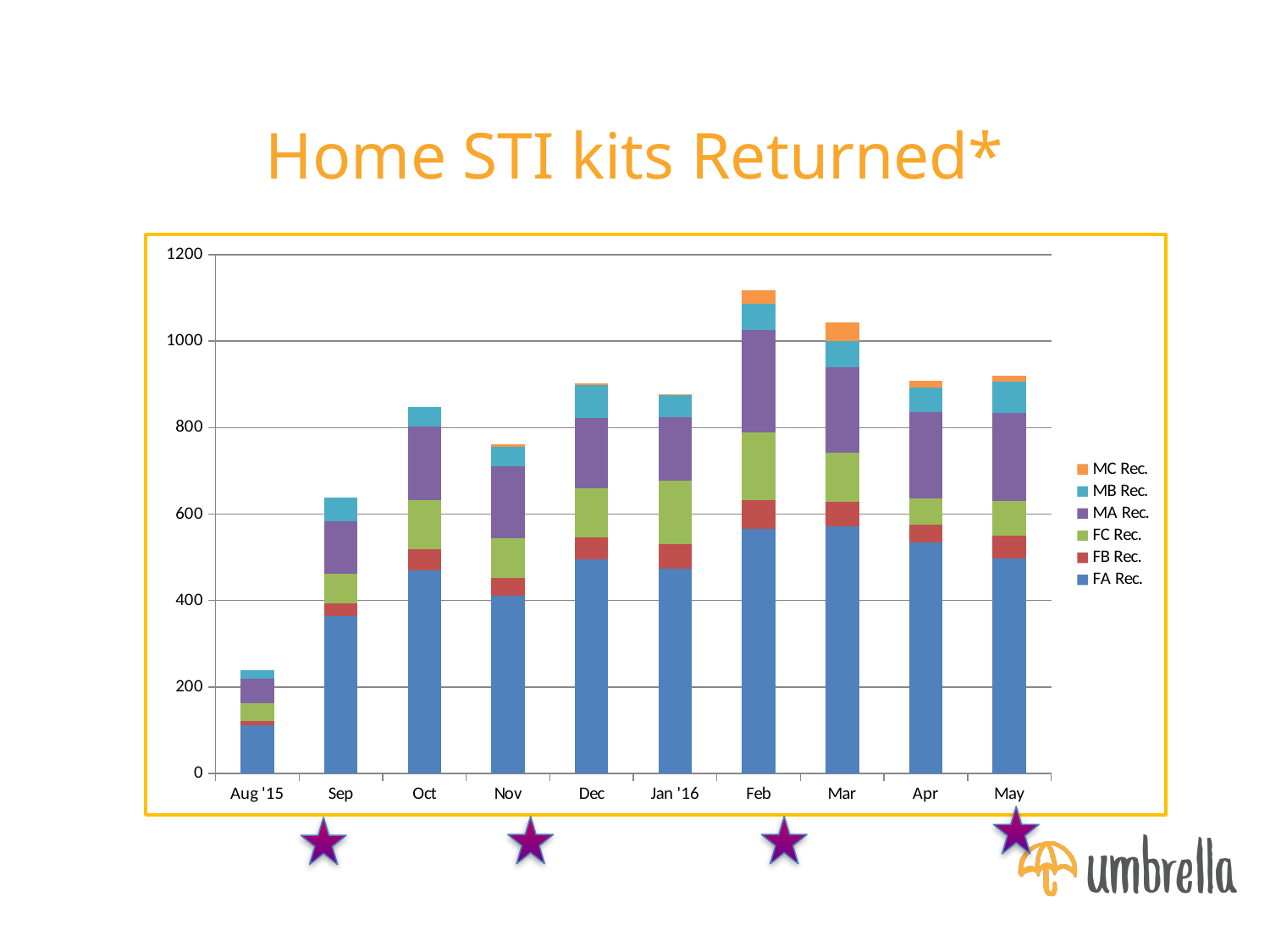
Is the total for Nov greater or less than 800? less Is the total for Feb greater or less than 1000? greater Is the total for Aug '15 greater or less than 400? less What kind of chart is shown on the slide? Stacked bar chart Which month has the lowest total of home STI kits returned? Aug '15 Do the total bar heights rise or fall from Aug '15 to Oct? rise How many months are shown on the x axis? 10 Which month has the highest total of home STI kits returned? Feb What is the title of the chart? Home STI kits Returned* Which month has a larger total, Oct or Nov? Oct How many series does the legend list? 6 Which series forms the bottom segment of each stacked bar? FA Rec.